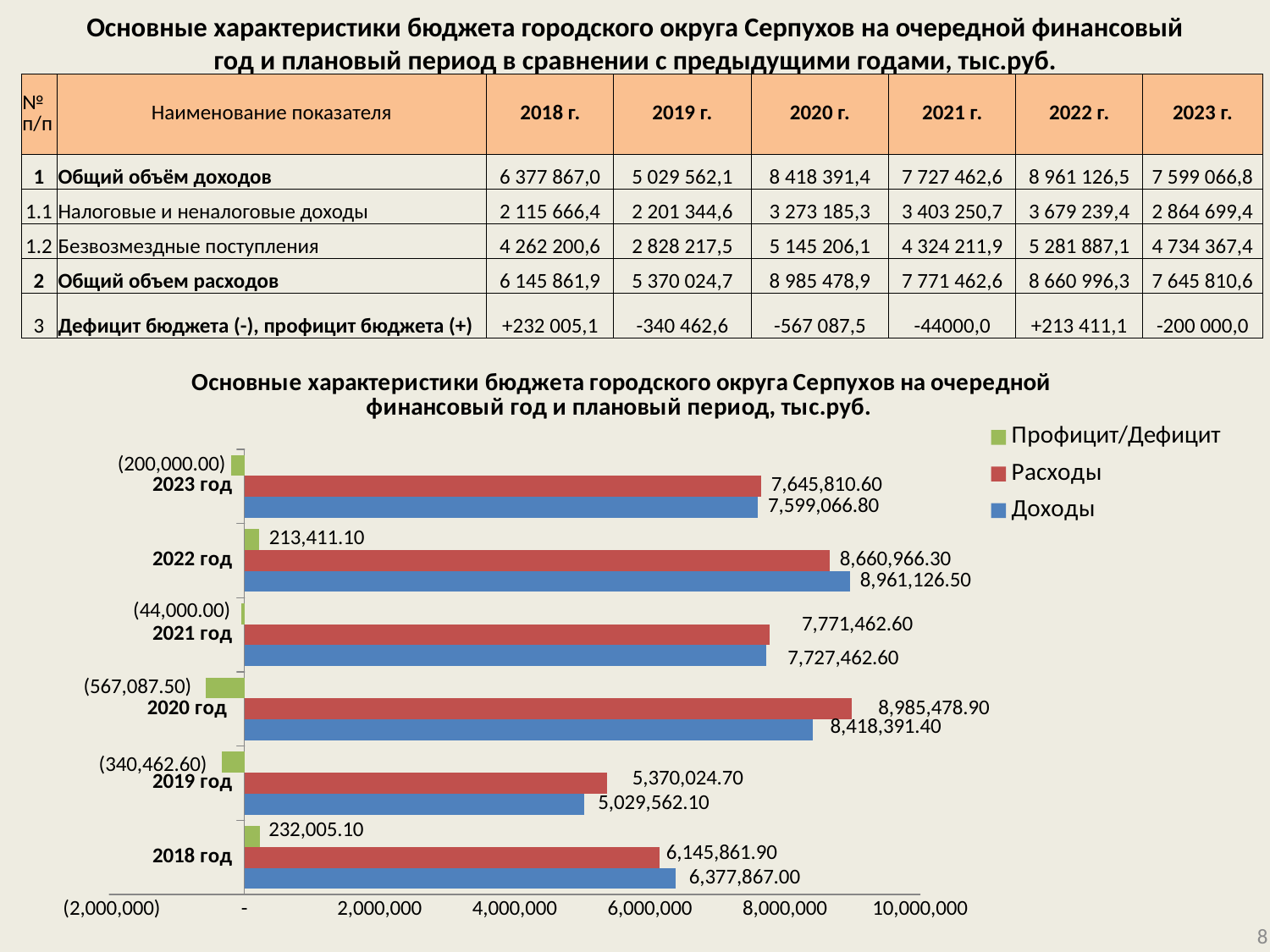
Which year has the lowest Расходы value in the chart? 2019 год How many years (categories) are plotted in the chart? 6 Which series in the chart legend is shown in green? Профицит/Дефицит In the chart, which is larger for 2020 год: Расходы or Доходы? Расходы Which year has the highest Доходы value in the chart? 2022 год What type of chart is shown on the slide? bar chart What is the value of Расходы for 2019 год in the chart? 5,370,024.70 What is the Профицит/Дефицит value for 2020 год in the chart? (567,087.50) How many series does the chart legend list? 3 What is the value of Доходы for 2022 год in the chart? 8,961,126.50 Is the Доходы value for 2019 год greater or less than 6,000,000? less What is the difference between Доходы and Расходы for 2022 год in the chart? 300,160.20